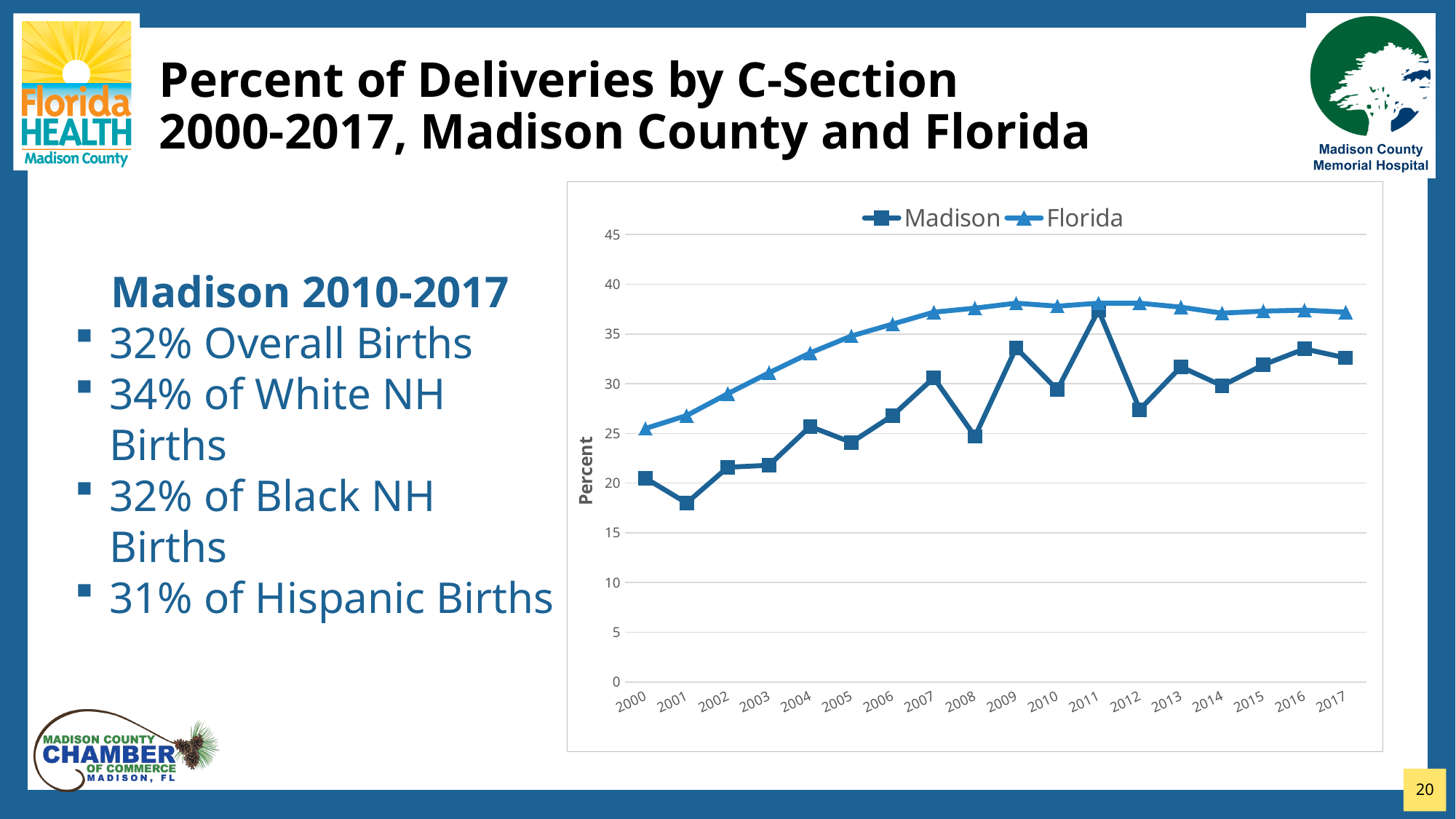
In which year is the Florida series at its lowest value? 2000 Does the Florida series rise or fall from 2000 to 2009? rise Which series has the larger value in 2005, Madison or Florida? Florida Is the value for Florida in 2017 greater or less than 35? greater How many years are plotted along the x axis of the chart? 18 What kind of chart is shown on the slide? line chart Is the value for Madison in 2012 greater or less than 30? less Is the value for Madison in 2001 greater or less than 20? less How many series does the chart's legend list? 2 In which year is the Madison series at its lowest value? 2001 In which year is the Madison series at its highest value? 2011 What is the label on the chart's vertical axis? Percent